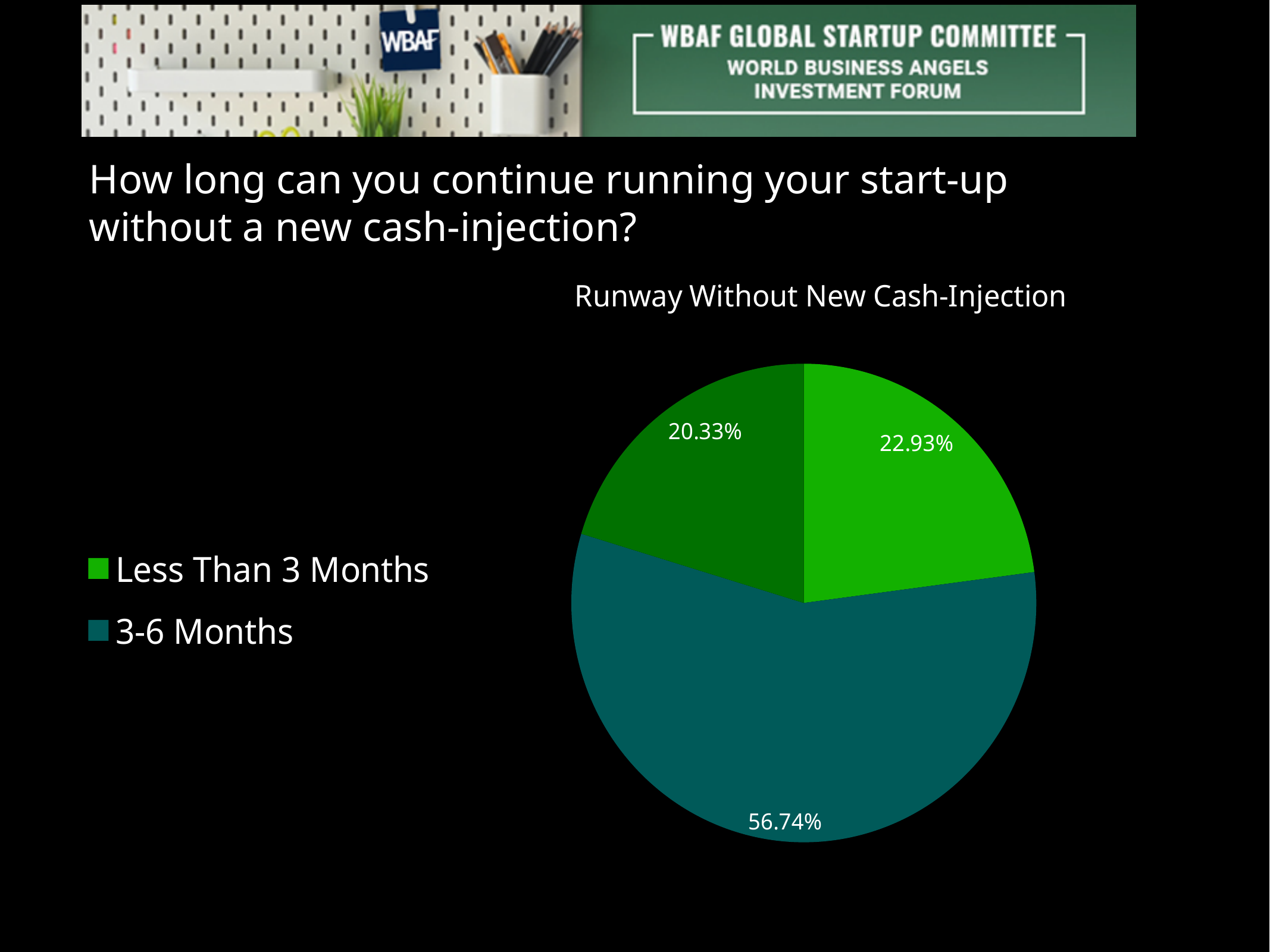
Is the share for 3-6 Months greater or less than 50%? greater What percentage of the pie is labelled for 3-6 Months? 56.74% What percentage of the pie is labelled for Less Than 3 Months? 22.93% What colour is the slice for 3-6 Months? dark teal How many slices does the pie chart have? 3 What is the difference in percentage points between the 3-6 Months slice and the Less Than 3 Months slice? 33.81% What is the smallest percentage value printed on the pie chart? 20.33% Which is larger: the slice for 3-6 Months or the slice for Less Than 3 Months? 3-6 Months What kind of chart is shown on the slide? pie chart How many entries does the legend list? 2 Which legend category has the largest slice of the pie? 3-6 Months What is the title of the chart? Runway Without New Cash-Injection